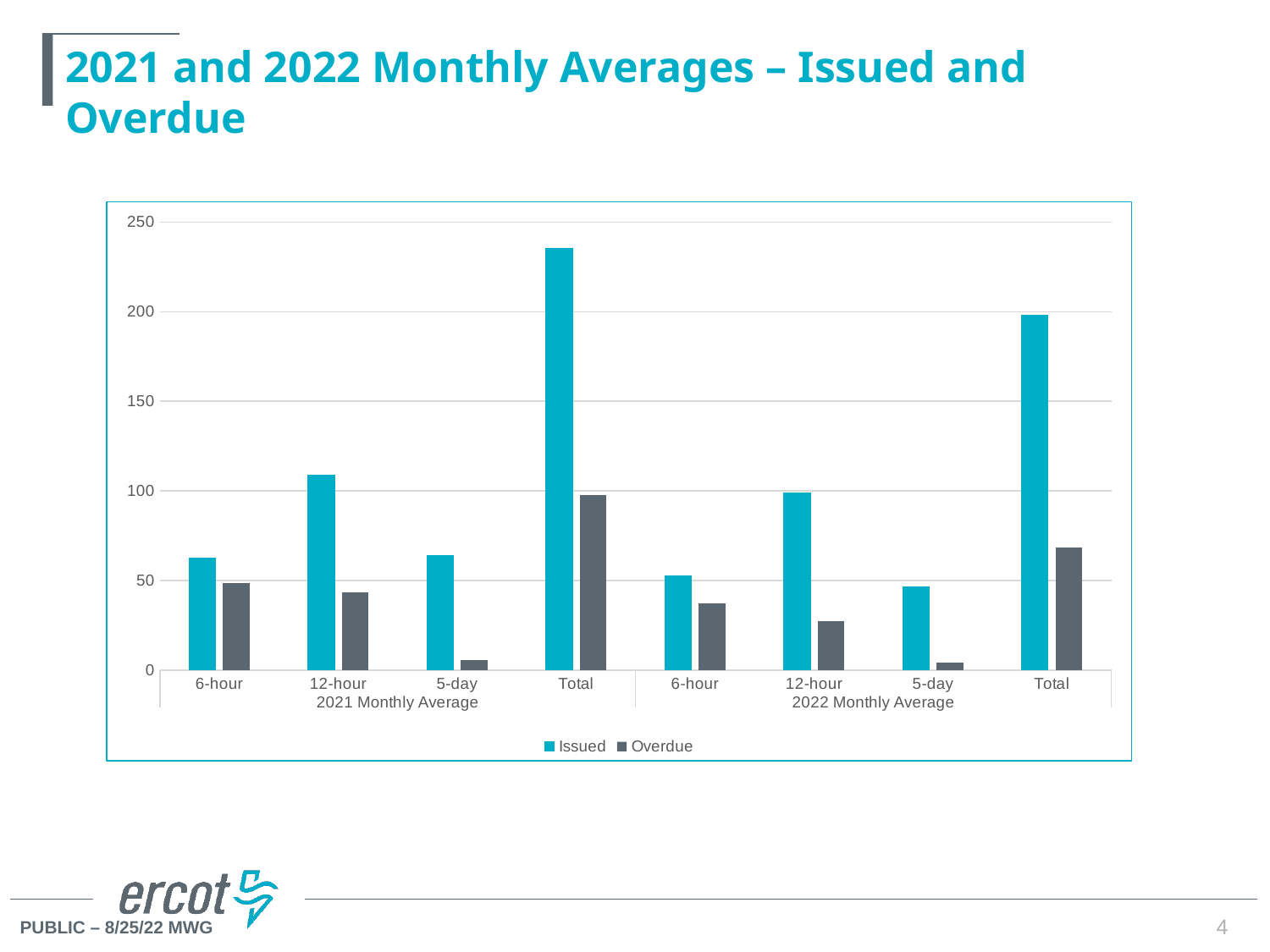
How many categories are shown along the x axis in total? 8 What are the two series named in the legend? Issued and Overdue Which is larger for 12-hour in the 2022 Monthly Average: Issued or Overdue? Issued Which category has the lowest Overdue bar? 5-day (2022 Monthly Average) How many series does the legend list? 2 Which is larger: the Issued value for Total in 2021 Monthly Average or the Issued value for Total in 2022 Monthly Average? Total in 2021 Monthly Average Is the Overdue value for Total in the 2022 Monthly Average greater or less than 50? greater Is the Issued value for Total in the 2021 Monthly Average greater or less than 200? greater What kind of chart is shown on the slide? Bar chart Which category has the highest Issued bar? Total (2021 Monthly Average) Is the Issued value for 12-hour in the 2021 Monthly Average greater or less than 100? greater